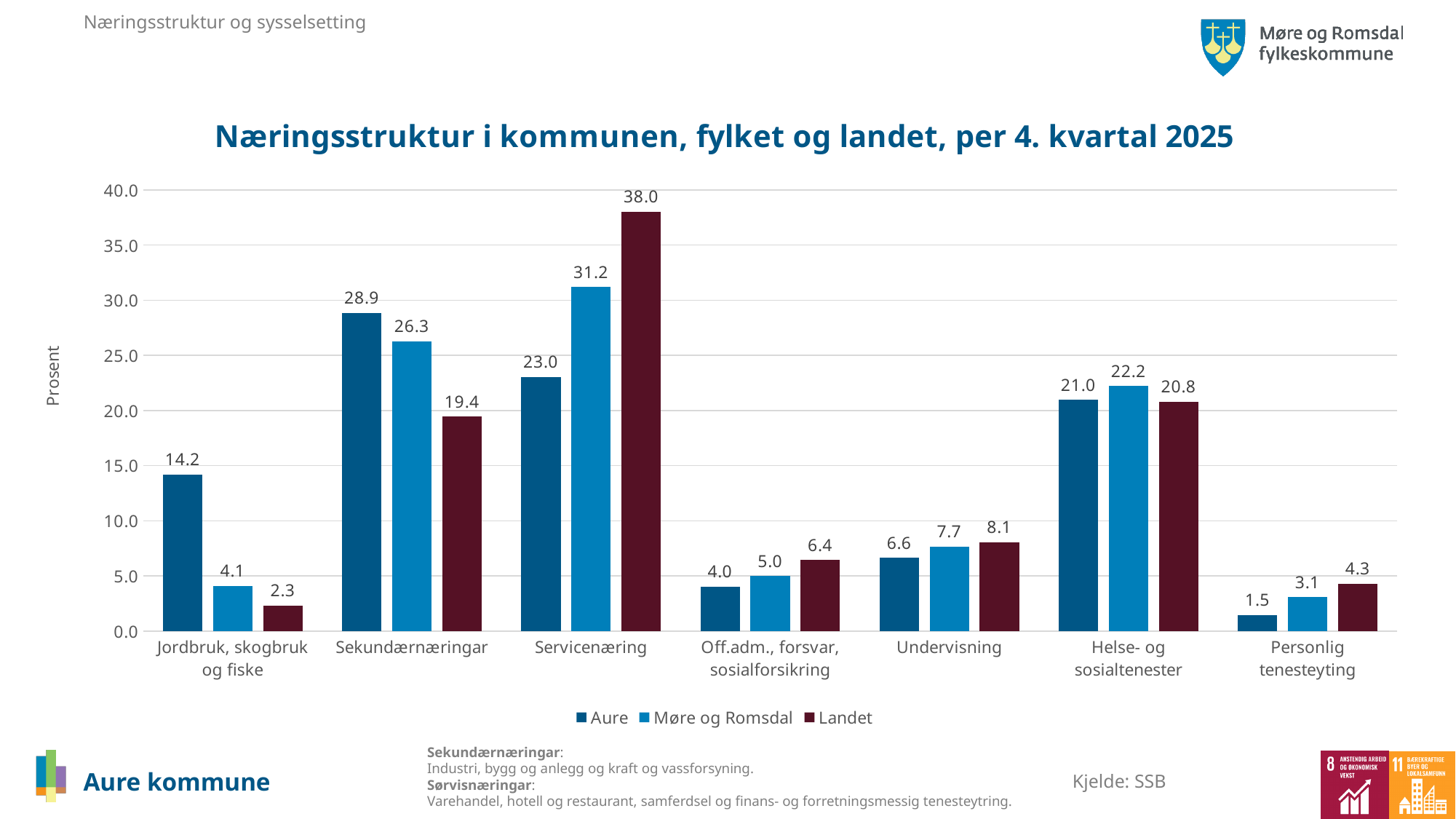
Is the value for Møre og Romsdal in the Servicenæring category greater or less than 30.0? greater Which is larger in the Sekundærnæringar category: Aure or Møre og Romsdal? Aure What is the difference between the Landet and Aure values in the Servicenæring category? 15.0 How many categories are shown on the x axis? 7 Which category has the highest value for Aure? Sekundærnæringar What kind of chart is shown on the slide? Bar chart What is the value for Landet in the Servicenæring category? 38.0 What is the value for Møre og Romsdal in the Helse- og sosialtenester category? 22.2 What is the label of the y axis? Prosent Which category has the lowest value for Landet? Jordbruk, skogbruk og fiske How many series does the legend list? 3 What is the value for Aure in the Jordbruk, skogbruk og fiske category? 14.2